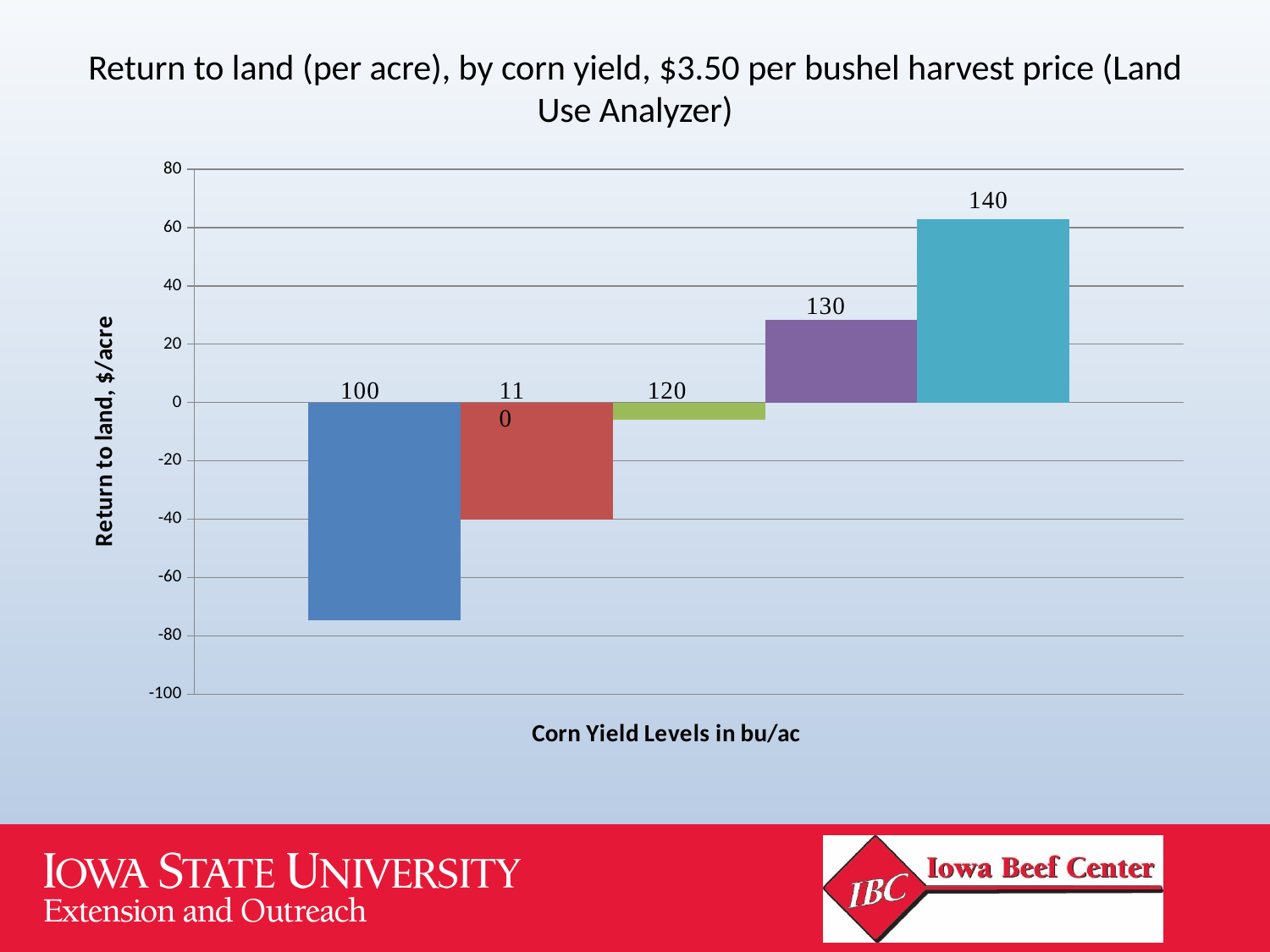
Which corn yield level has the lowest return to land? 100 What kind of chart is shown on the slide? bar chart Is the return to land for the 100 bu/ac yield level greater or less than -60? less Do the return-to-land values rise or fall as corn yield increases along the x axis? rise Is the return to land for the 130 bu/ac yield level greater or less than 20? greater What is the label of the y axis? Return to land, $/acre Is the return to land for the 140 bu/ac yield level greater or less than 40? greater How many corn yield levels are plotted in the chart? 5 Which corn yield level has the highest return to land? 140 Which has a larger return to land, the 130 bu/ac yield level or the 110 bu/ac yield level? 130